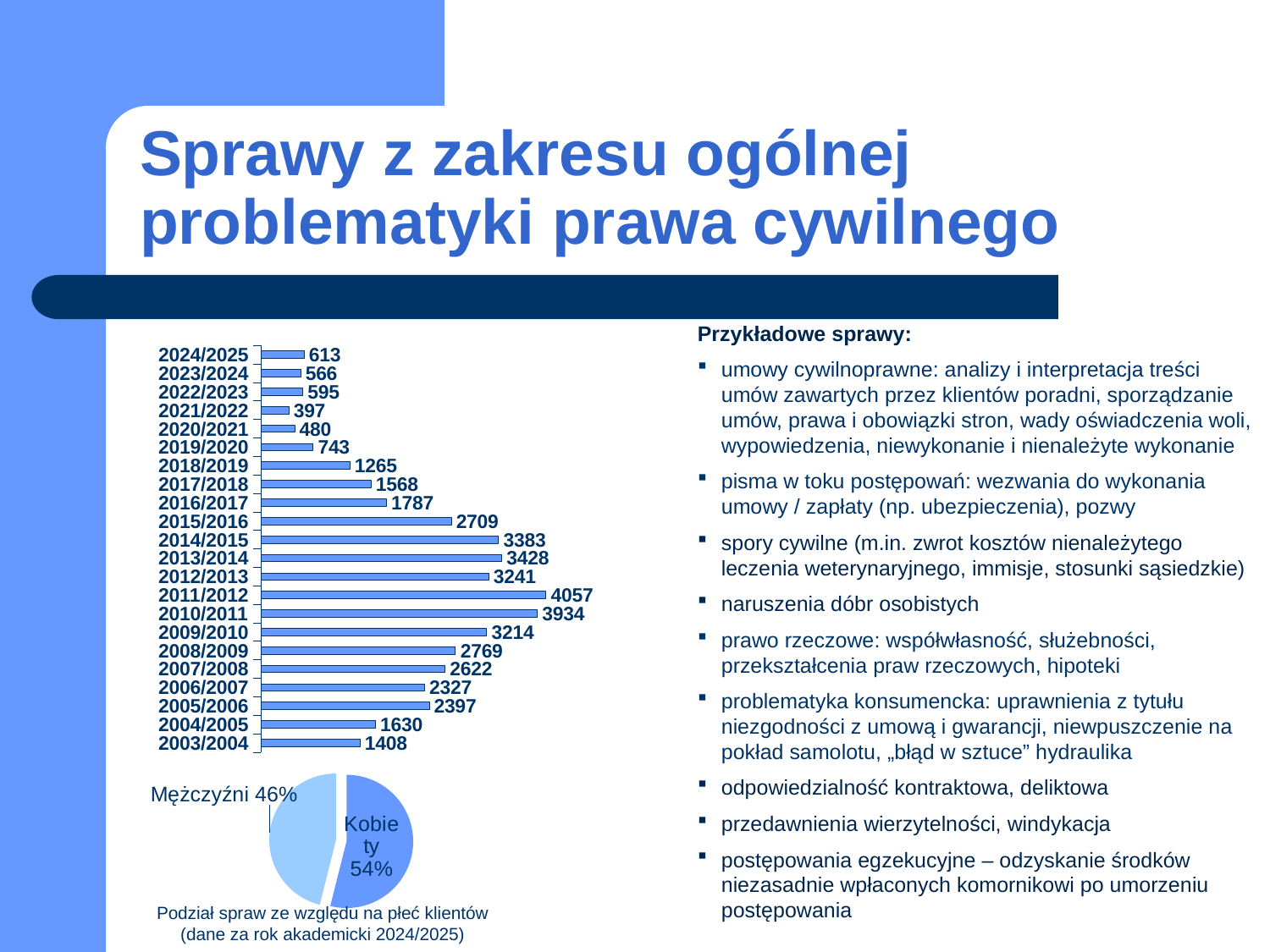
In the bar chart, which academic year has the lowest value? 2021/2022 In the bar chart, how many academic years are shown? 22 In the pie chart, what share is labelled Kobiety? 54% In the bar chart, what is the value for 2011/2012? 4057 In the bar chart, what is the value for 2024/2025? 613 What is the caption below the pie chart? Podział spraw ze względu na płeć klientów (dane za rok akademicki 2024/2025) In the pie chart, what share is labelled Mężczyźni? 46% In the bar chart, what is the value for 2003/2004? 1408 In the bar chart, what is the difference between the values for 2011/2012 and 2010/2011? 123 What kind of chart is the upper chart on the left of the slide? bar chart In the bar chart, which academic year has the highest value? 2011/2012 In the bar chart, which is larger, the value for 2014/2015 or the value for 2013/2014? 2013/2014